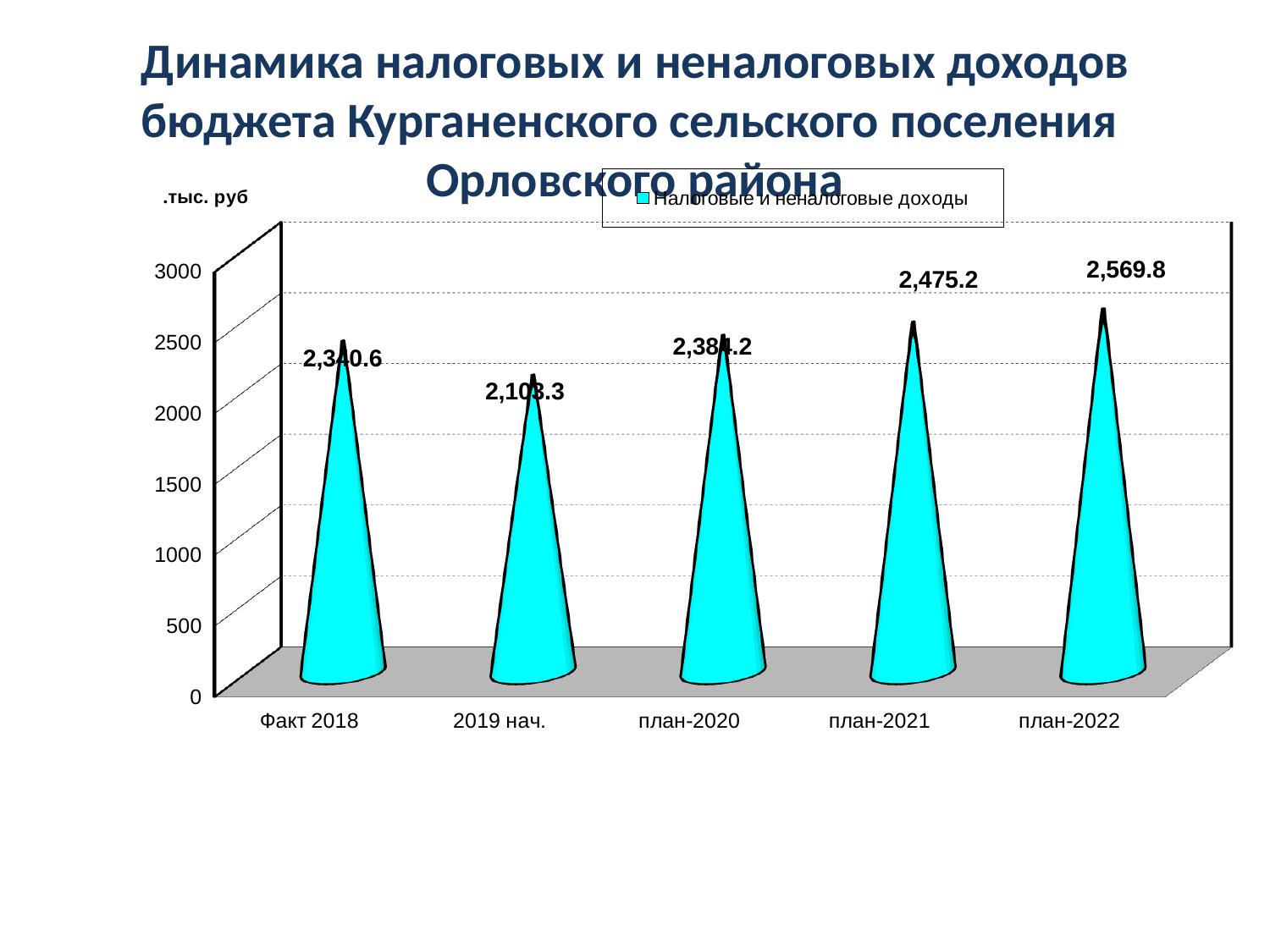
How many series does the legend list? 1 What is the difference between the values for план-2022 and план-2021? 94.6 How many categories are shown on the x axis? 5 Which is larger, the value for план-2021 or the value for план-2020? план-2021 Which category has the highest value? план-2022 Is the value for план-2022 greater or less than 2500? greater Is the value for Факт 2018 greater or less than 2500? less Which category has the lowest value? 2019 нач. What series name is shown in the legend? Налоговые и неналоговые доходы What is the value for план-2022? 2,569.8 What kind of chart is shown on the slide? bar chart What is the value for план-2021? 2,475.2